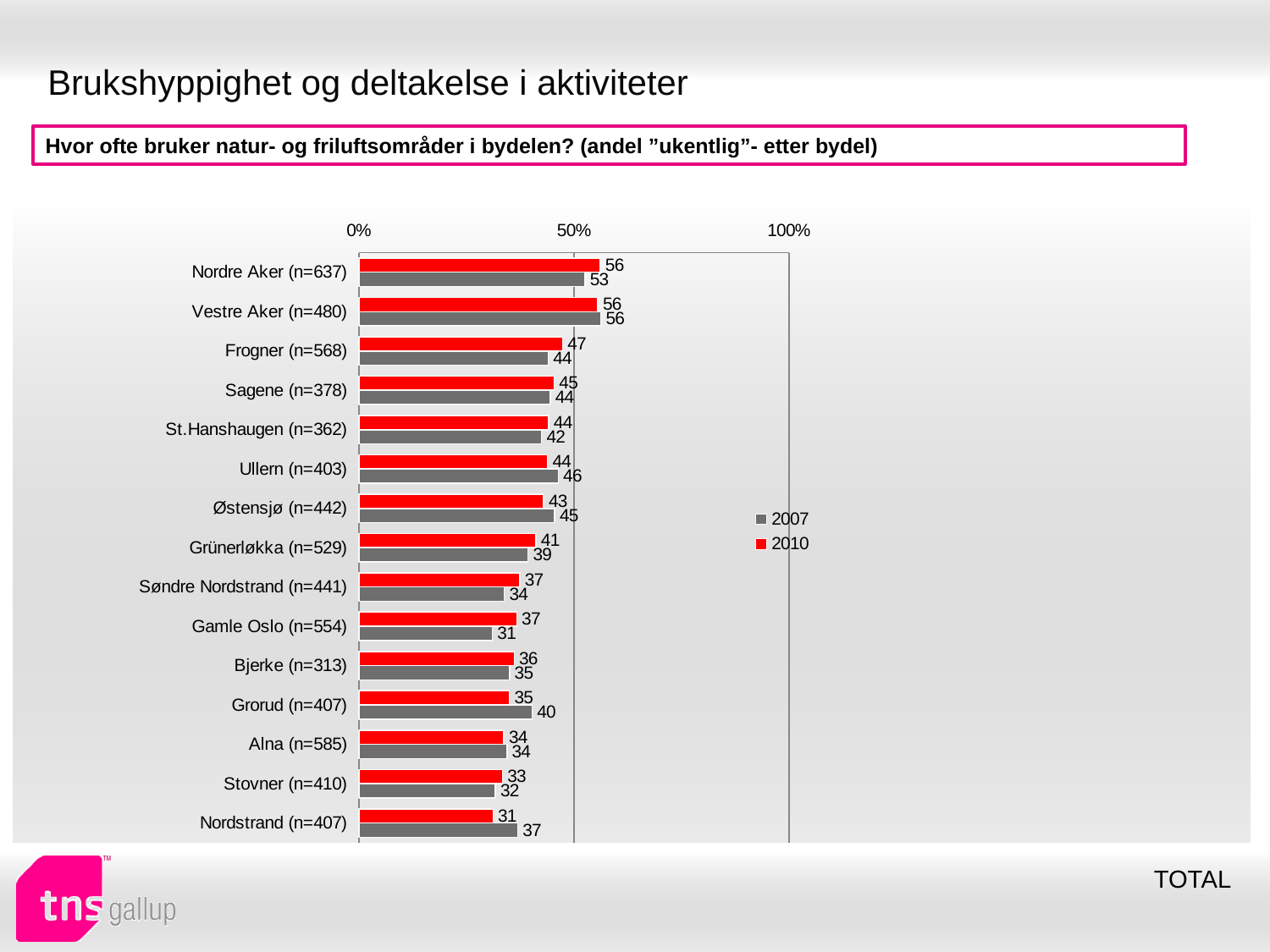
What is the 2007 value for Nordre Aker (n=637)? 53 Which bydel has the highest 2007 value? Vestre Aker (n=480) How many series does the legend list? 2 Which colour represents the 2010 series in the chart? red Which bydel has the lowest 2010 value? Nordstrand (n=407) Which bydel has the lowest 2007 value? Gamle Oslo (n=554) For Nordstrand (n=407), which is larger: the 2007 value or the 2010 value? 2007 What type of chart is shown on the slide? bar chart What is the 2010 value for Frogner (n=568)? 47 What is the 2007 value for Grorud (n=407)? 40 What is the difference between the 2010 and 2007 values for Gamle Oslo (n=554)? 6 How many bydeler (categories) are shown in the chart? 15